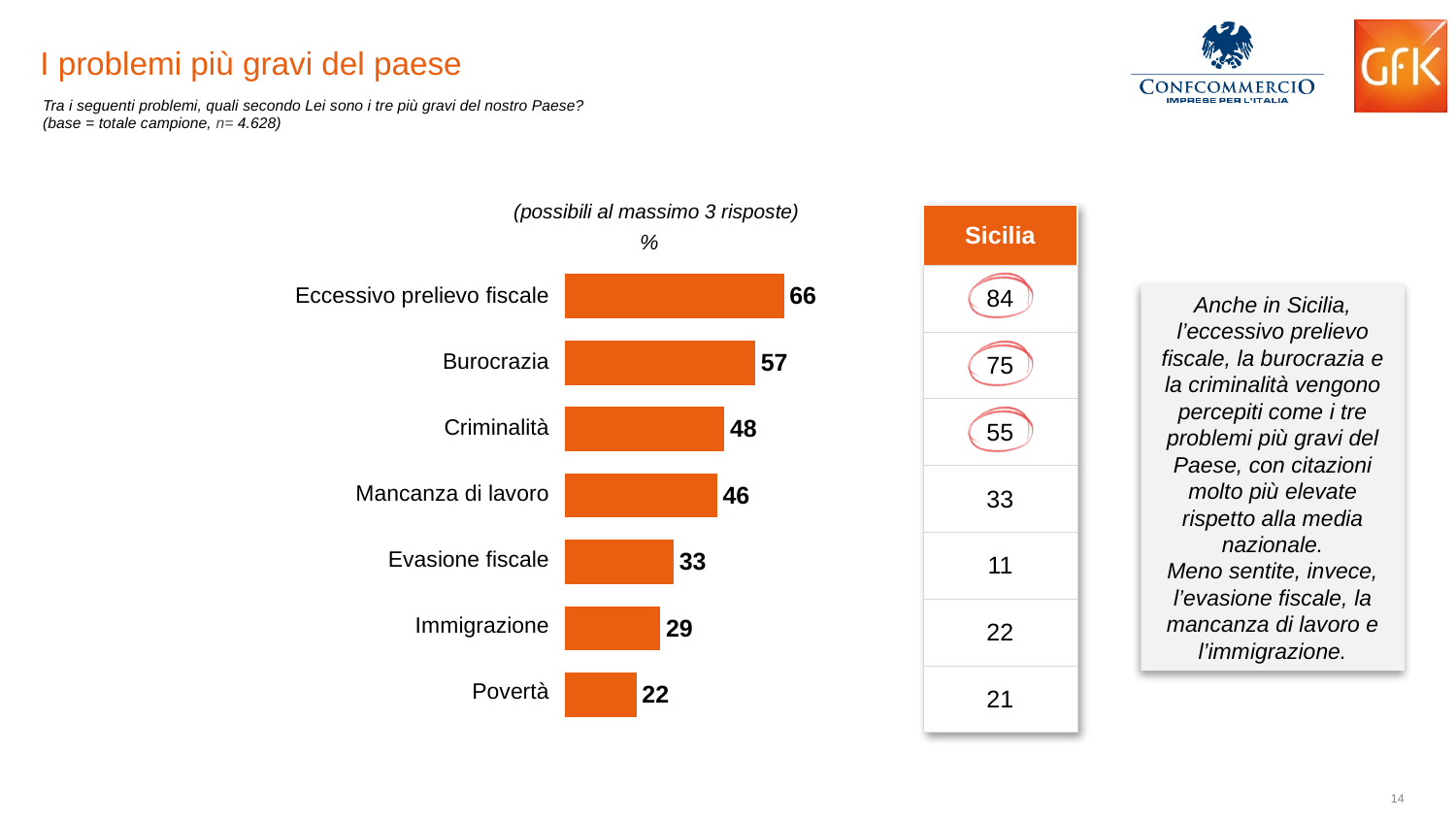
Which category has the lowest value in the bar chart? Povertà What is the difference between the values for Evasione fiscale and Povertà in the bar chart? 11 How many categories are shown in the bar chart? 7 What kind of chart is shown on the slide? Bar chart Do the values in the bar chart rise or fall going from the top category to the bottom category? Fall What is the title of the slide containing the bar chart? I problemi più gravi del paese What is the value for Mancanza di lavoro in the bar chart? 46 What is the value for Eccessivo prelievo fiscale in the bar chart? 66 What is the value for Immigrazione in the bar chart? 29 Which has a larger value in the bar chart, Criminalità or Evasione fiscale? Criminalità What is the difference between the values for Burocrazia and Criminalità in the bar chart? 9 Which category has the highest value in the bar chart? Eccessivo prelievo fiscale